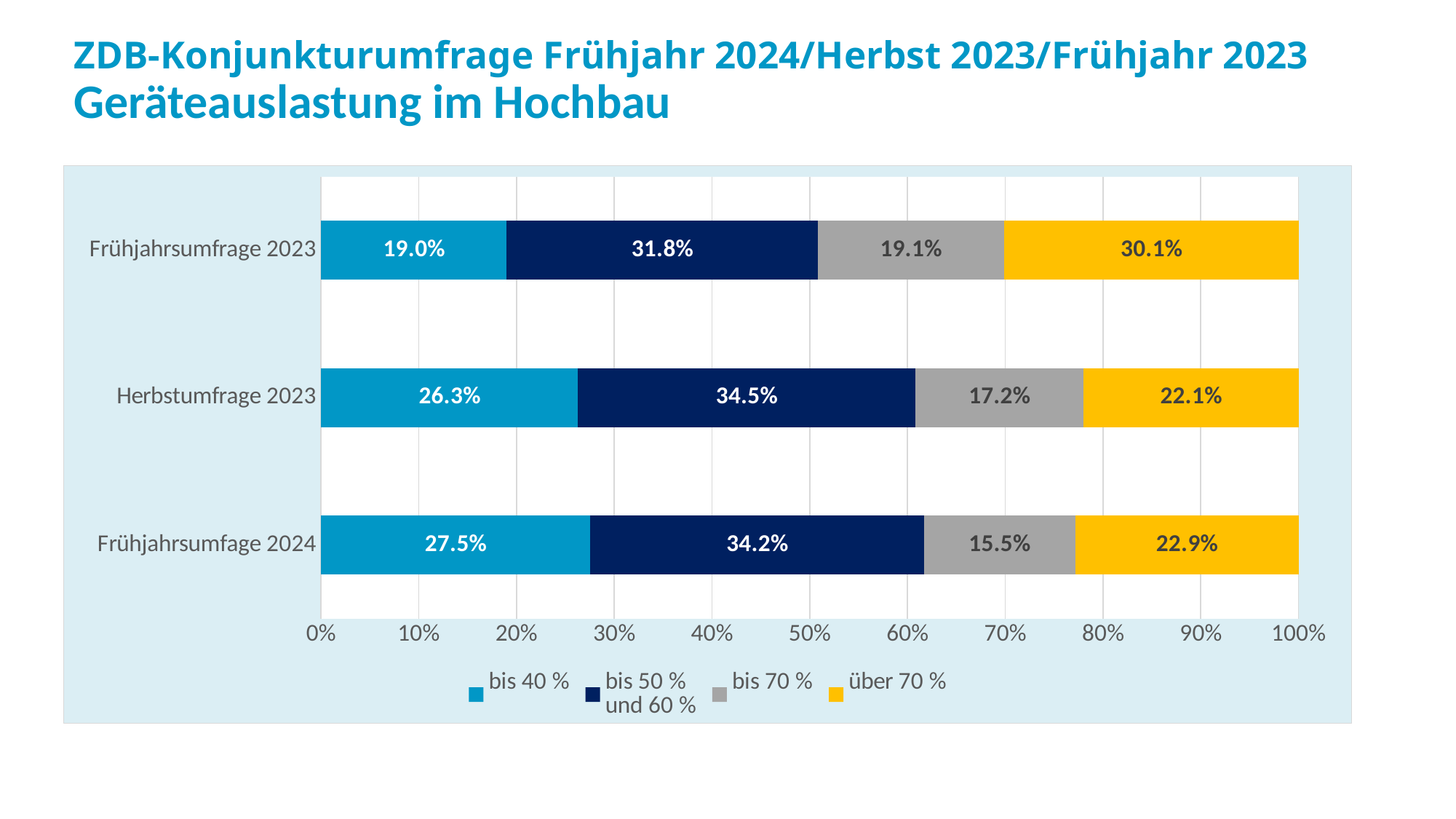
What is the value of 'bis 70 %' for Frühjahrsumfage 2024? 15.5% Does the 'bis 40 %' share rise or fall from Frühjahrsumfrage 2023 through Herbstumfrage 2023 to Frühjahrsumfage 2024? Rise How many survey categories are plotted on the chart? 3 Which colour represents the 'über 70 %' series in the chart? Yellow What is the difference between the 'über 70 %' values for Frühjahrsumfrage 2023 and Frühjahrsumfage 2024? 7.2% What is the value of 'über 70 %' for Herbstumfrage 2023? 22.1% What is the value of 'bis 40 %' for Frühjahrsumfrage 2023? 19.0% What kind of chart is shown on the slide? Stacked bar chart Which survey has the highest value for 'bis 40 %'? Frühjahrsumfage 2024 How many series does the legend list? 4 Which is larger: the 'bis 50 % und 60 %' value for Herbstumfrage 2023 or for Frühjahrsumfrage 2023? Herbstumfrage 2023 Which survey has the lowest value for 'über 70 %'? Herbstumfrage 2023